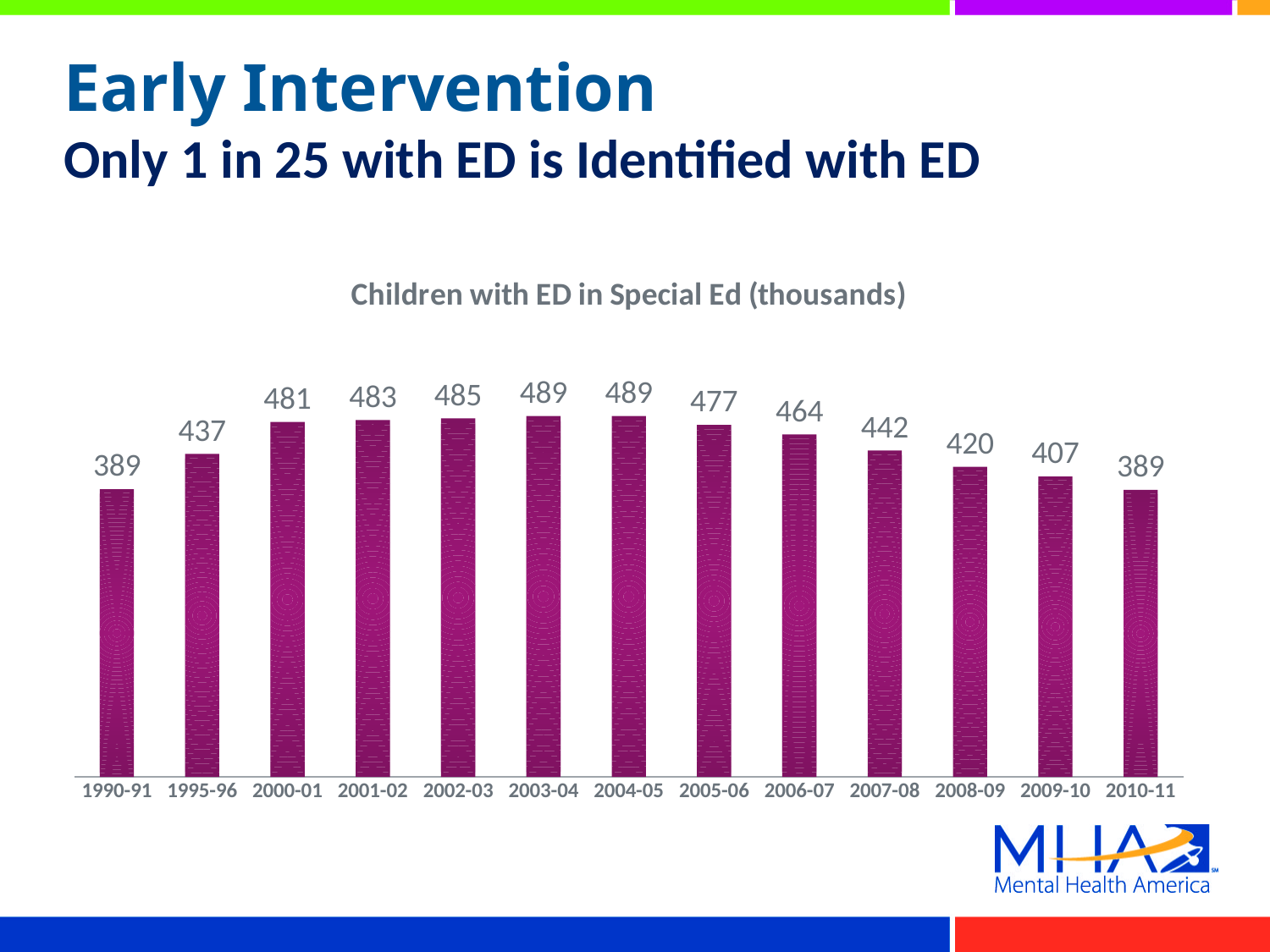
What is the difference between the values for 1990-91 and 1995-96? 48 How many categories are shown on the x axis? 13 What is the title of the chart? Children with ED in Special Ed (thousands) Which years have the highest value? 2003-04 and 2004-05 What is the value for 1995-96? 437 What is the difference between the values for 2000-01 and 2008-09? 61 What kind of chart is this? Bar chart What is the value for 2006-07? 464 Do the values rise or fall from 2004-05 to 2010-11? Fall Which years have the lowest value? 1990-91 and 2010-11 Which is larger, the value for 2005-06 or the value for 2007-08? 2005-06 What is the value for 2010-11? 389